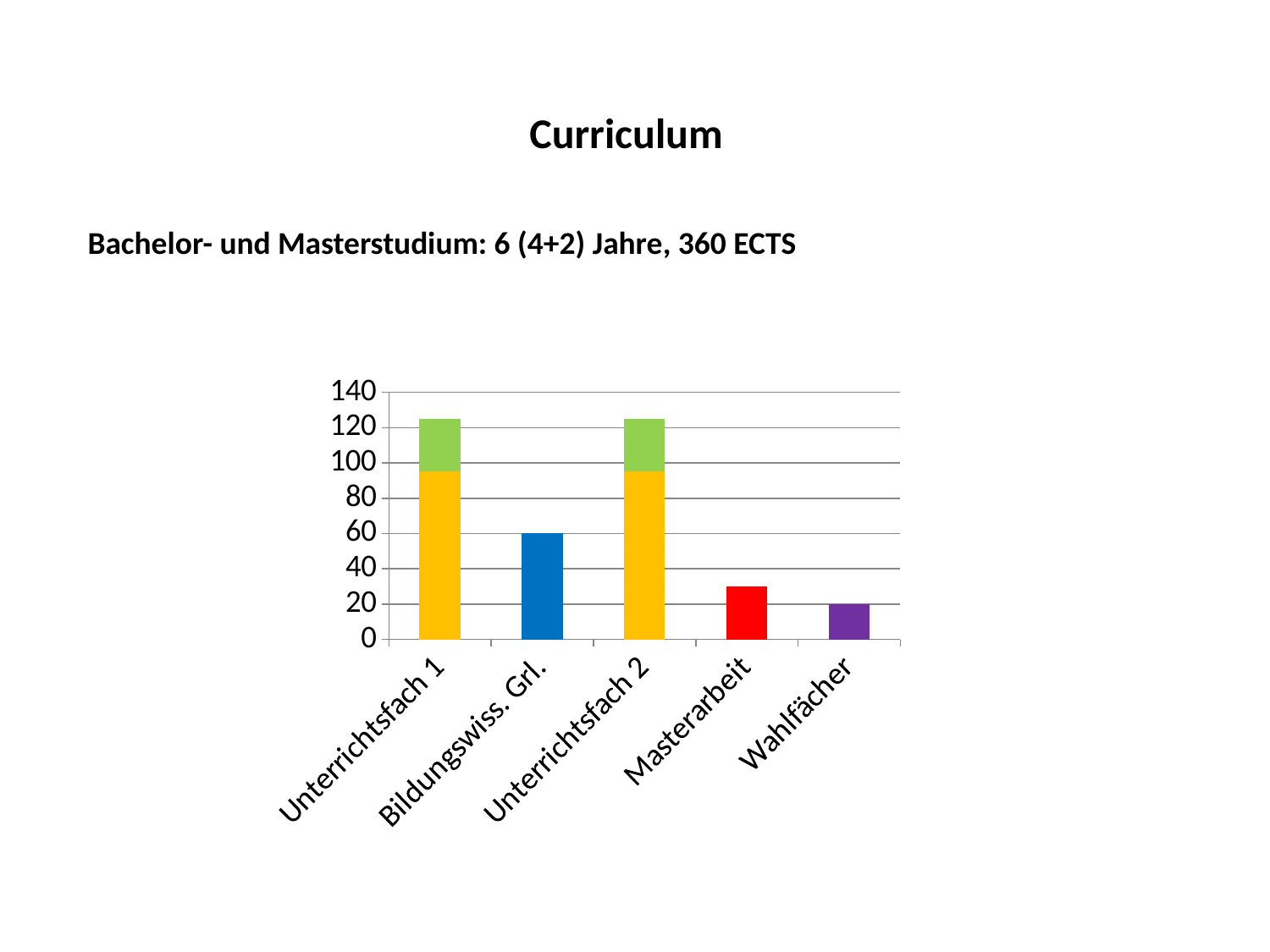
What kind of chart is shown on the slide? bar chart Which category has the lowest value? Wahlfächer What is the value for Wahlfächer? 20 What is the difference between the values for Bildungswiss. Grl. and Wahlfächer? 40 What is the value for Bildungswiss. Grl.? 60 Is the total for Unterrichtsfach 2 greater or less than 100? greater Which is larger, the total for Unterrichtsfach 1 or the value for Bildungswiss. Grl.? Unterrichtsfach 1 Is the value for Masterarbeit greater or less than 40? less Is the value for Masterarbeit greater or less than 20? greater Which is larger, the value for Bildungswiss. Grl. or the value for Masterarbeit? Bildungswiss. Grl. How many categories are shown on the x axis? 5 What colour is the bar for Masterarbeit? red